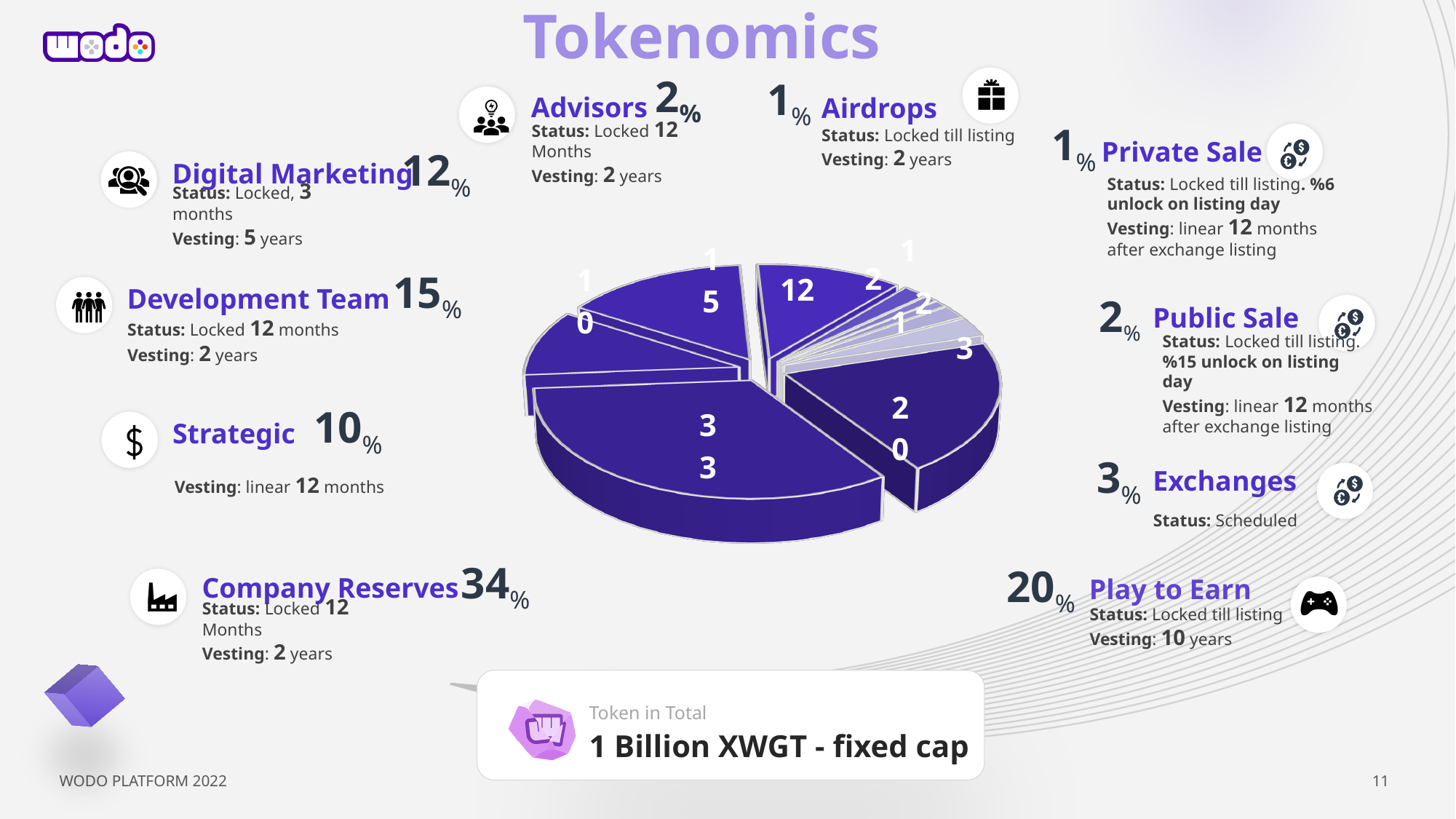
What percentage is allocated to Strategic? 10% What is the total token supply stated on the slide? 1 Billion XWGT - fixed cap What kind of chart is shown on the slide? pie chart What percentage is allocated to Exchanges? 3% How many slices does the pie chart have? 10 What is the title of the slide containing the pie chart? Tokenomics What percentage is allocated to Digital Marketing? 12% What share of the tokens is allocated to Play to Earn? 20% What percentage is allocated to the Development Team? 15% Which is larger, the share for Play to Earn or the share for the Development Team? Play to Earn What is the difference in percentage points between the Development Team share and the Digital Marketing share? 3 Which category has the largest share of the pie chart? Company Reserves